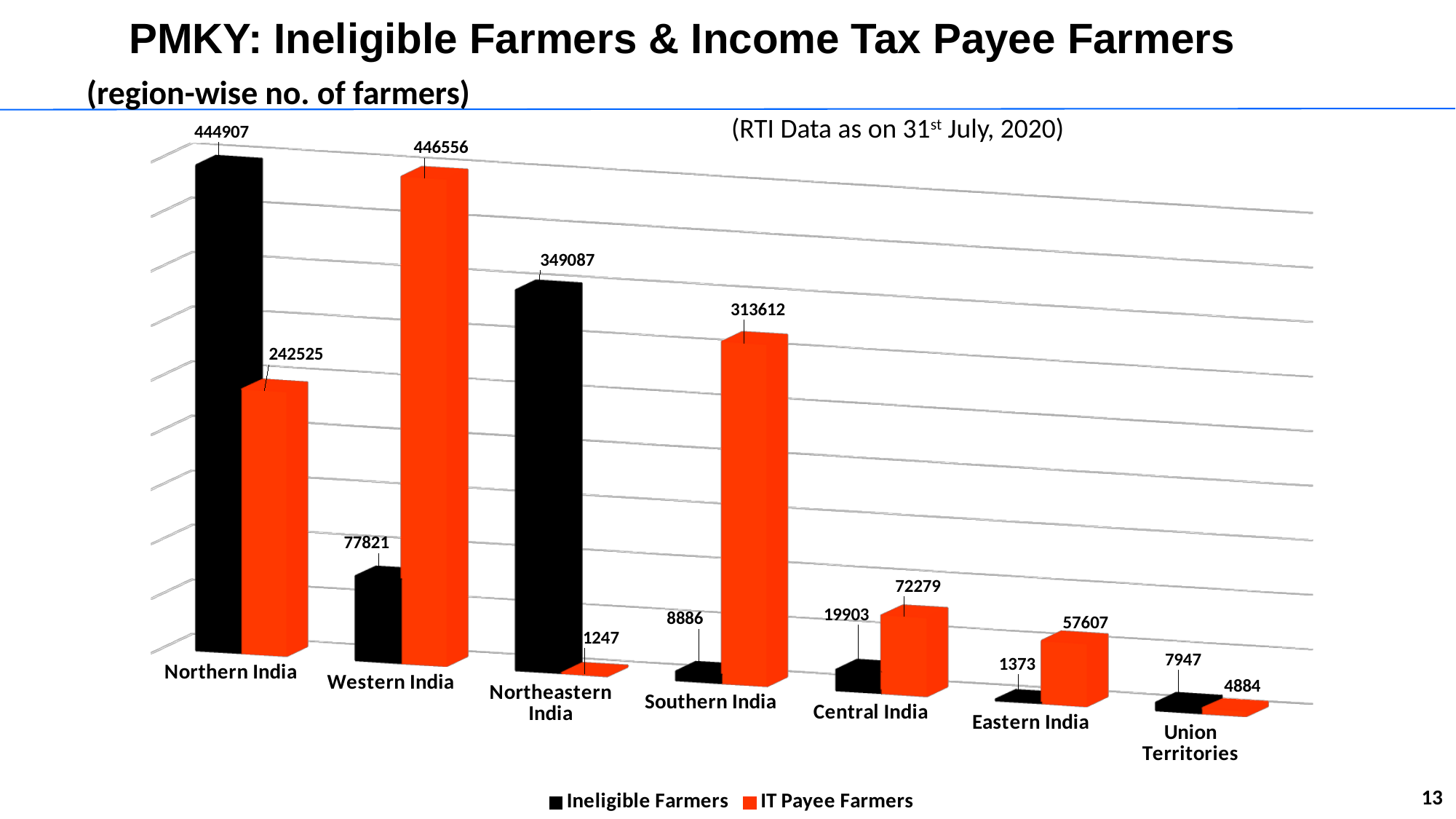
What is the number of IT Payee Farmers for Northeastern India? 1247 How many regions are shown on the x axis? 7 What is the difference between Ineligible Farmers and IT Payee Farmers for Northern India? 202382 Which colour represents IT Payee Farmers in the chart? Orange What is the number of IT Payee Farmers for Western India? 446556 What kind of chart is shown on the slide? Bar chart How many series does the legend list? 2 What is the number of Ineligible Farmers for Northern India? 444907 Which region has the lowest number of IT Payee Farmers? Northeastern India Which region has the highest number of Ineligible Farmers? Northern India What is the number of Ineligible Farmers for Central India? 19903 Which is larger for Southern India: Ineligible Farmers or IT Payee Farmers? IT Payee Farmers